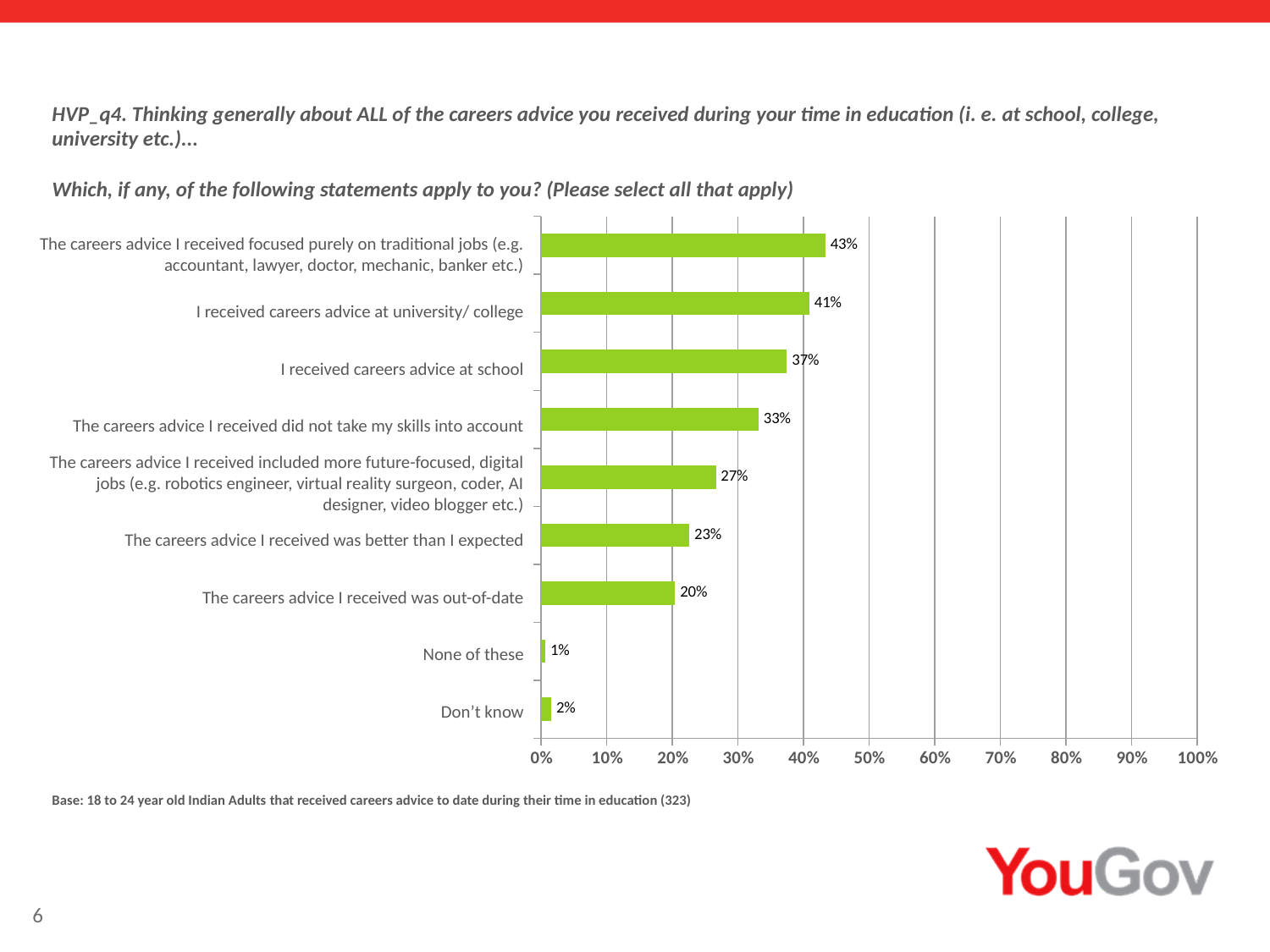
What percentage said the careers advice they received was out-of-date? 20% What is the difference between "I received careers advice at university/ college" and "I received careers advice at school"? 4% What percentage of respondents said the careers advice they received focused purely on traditional jobs? 43% What is the value for "Don't know"? 2% What kind of chart is shown on the slide? Bar chart How many categories are shown in the chart? 9 Which is larger: the value for "The careers advice I received did not take my skills into account" or "The careers advice I received was better than I expected"? The careers advice I received did not take my skills into account What is the maximum value shown on the horizontal axis? 100% Which statement has the highest percentage? The careers advice I received focused purely on traditional jobs (e.g. accountant, lawyer, doctor, mechanic, banker etc.) Is the value for "The careers advice I received included more future-focused, digital jobs" greater or less than 30%? less What is the value for "I received careers advice at school"? 37% Which category has the lowest percentage? None of these